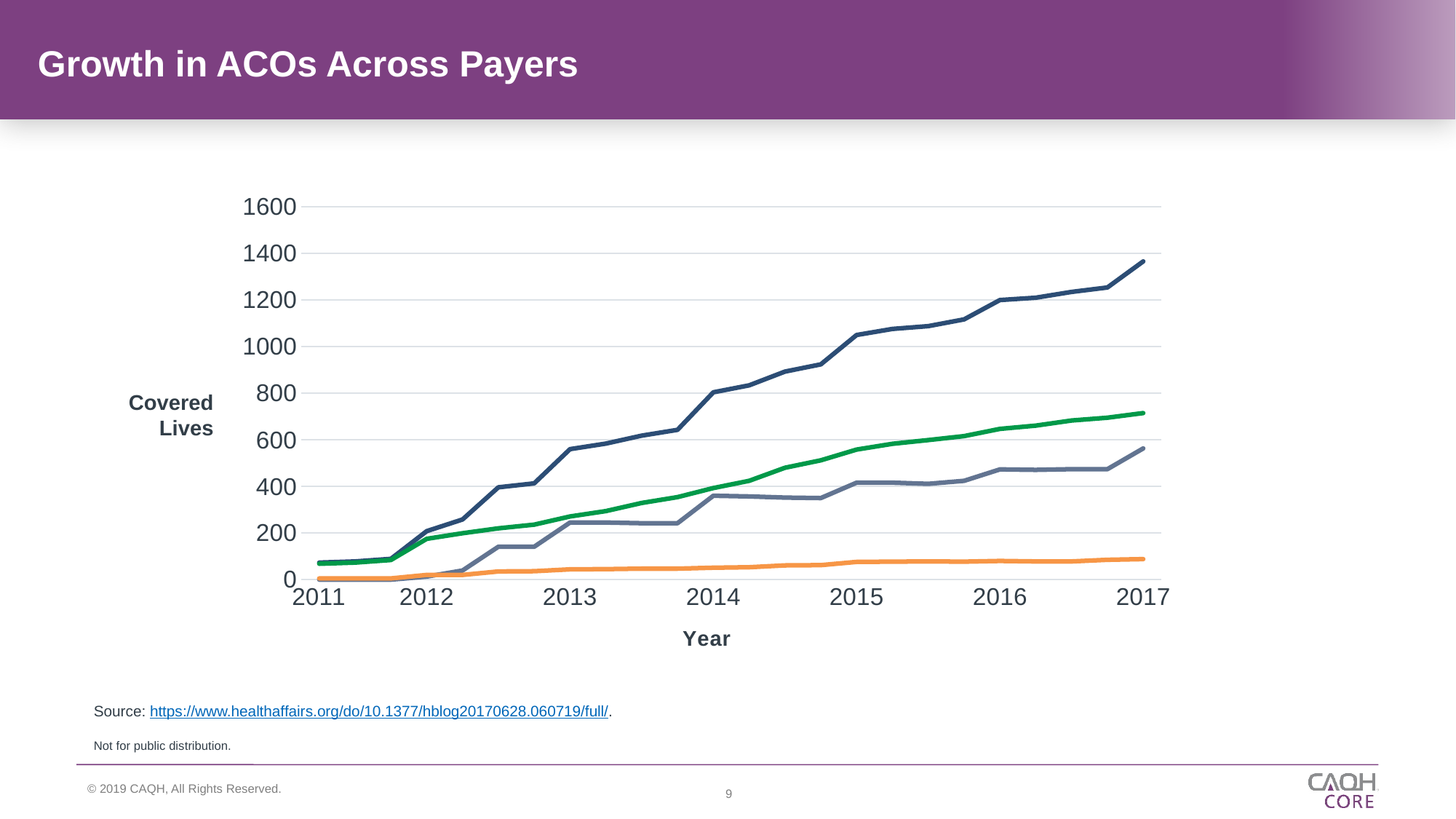
What is the title of the chart on the slide? Growth in ACOs Across Payers In 2017, which is larger: the value of the green line or the value of the grey-blue line? the green line Does the dark blue line rise or fall from 2011 to 2017? rise Is the value of the dark blue line in 2015 greater or less than 1000? greater What is the label on the vertical axis of the chart? Covered Lives Is the value of the orange line in 2017 greater or less than 200? less Is the value of the green line in 2017 greater or less than 600? greater How many years are labelled along the x axis of the chart? 7 Which line has the highest value in 2017? the dark blue line Which line has the lowest value in 2017? the orange line What kind of chart is shown on the slide? line chart